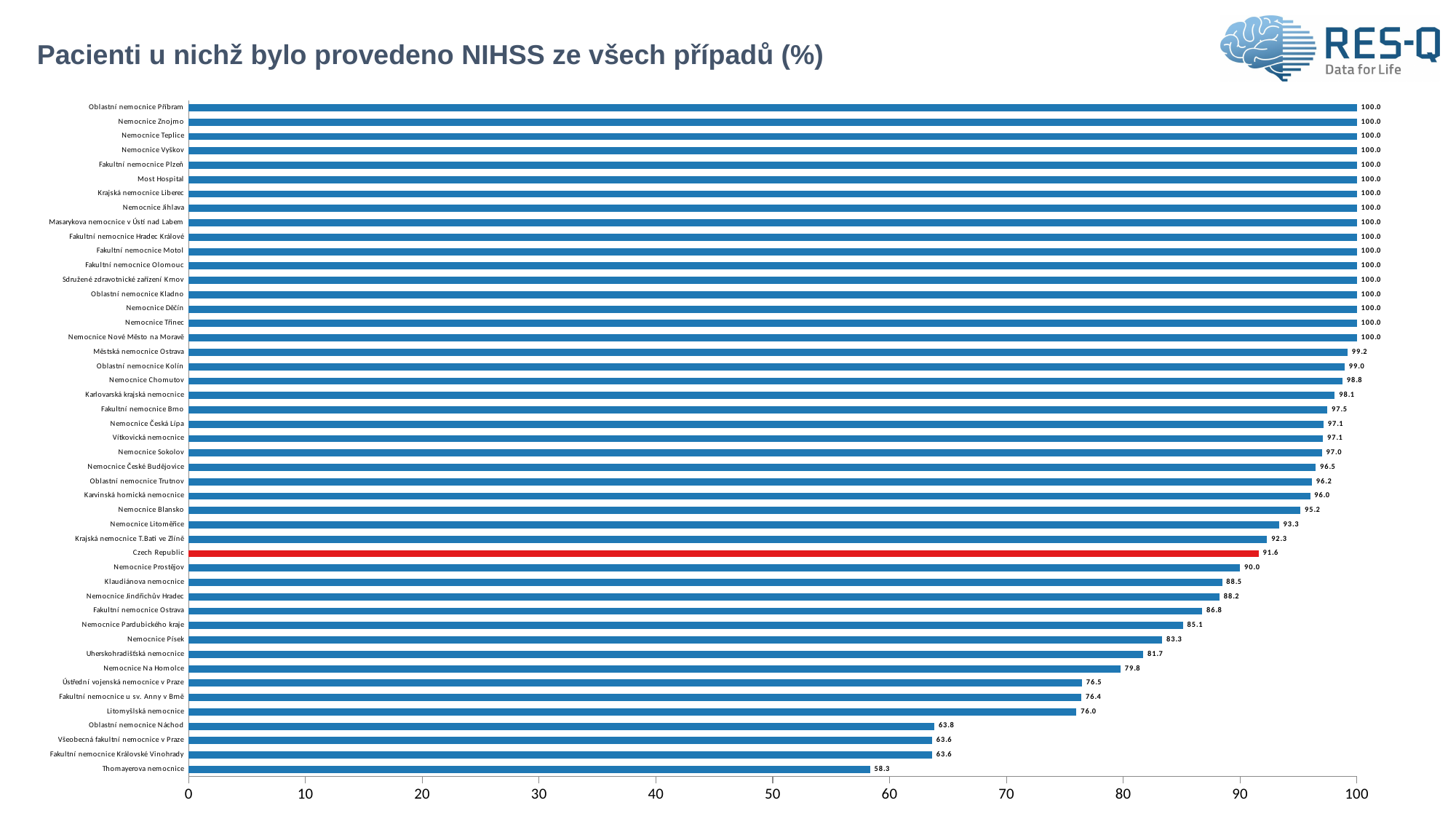
What is the difference between the values for Nemocnice Prostějov and Nemocnice Písek? 6.7 What is the value for Czech Republic? 91.6 Is the value for Oblastní nemocnice Náchod greater or less than 70? less Which bar is highlighted in red? Czech Republic What is the value for Nemocnice Na Homolce? 79.8 How many hospitals/categories are plotted in the chart? 47 Which is larger, the value for Nemocnice Litoměřice or the value for Klaudiánova nemocnice? Nemocnice Litoměřice What is the difference between the values for Czech Republic and Thomayerova nemocnice? 33.3 What is the value for Fakultní nemocnice Brno? 97.5 Which hospital has the lowest value? Thomayerova nemocnice What is the value for Thomayerova nemocnice? 58.3 What kind of chart is shown on the slide? bar chart